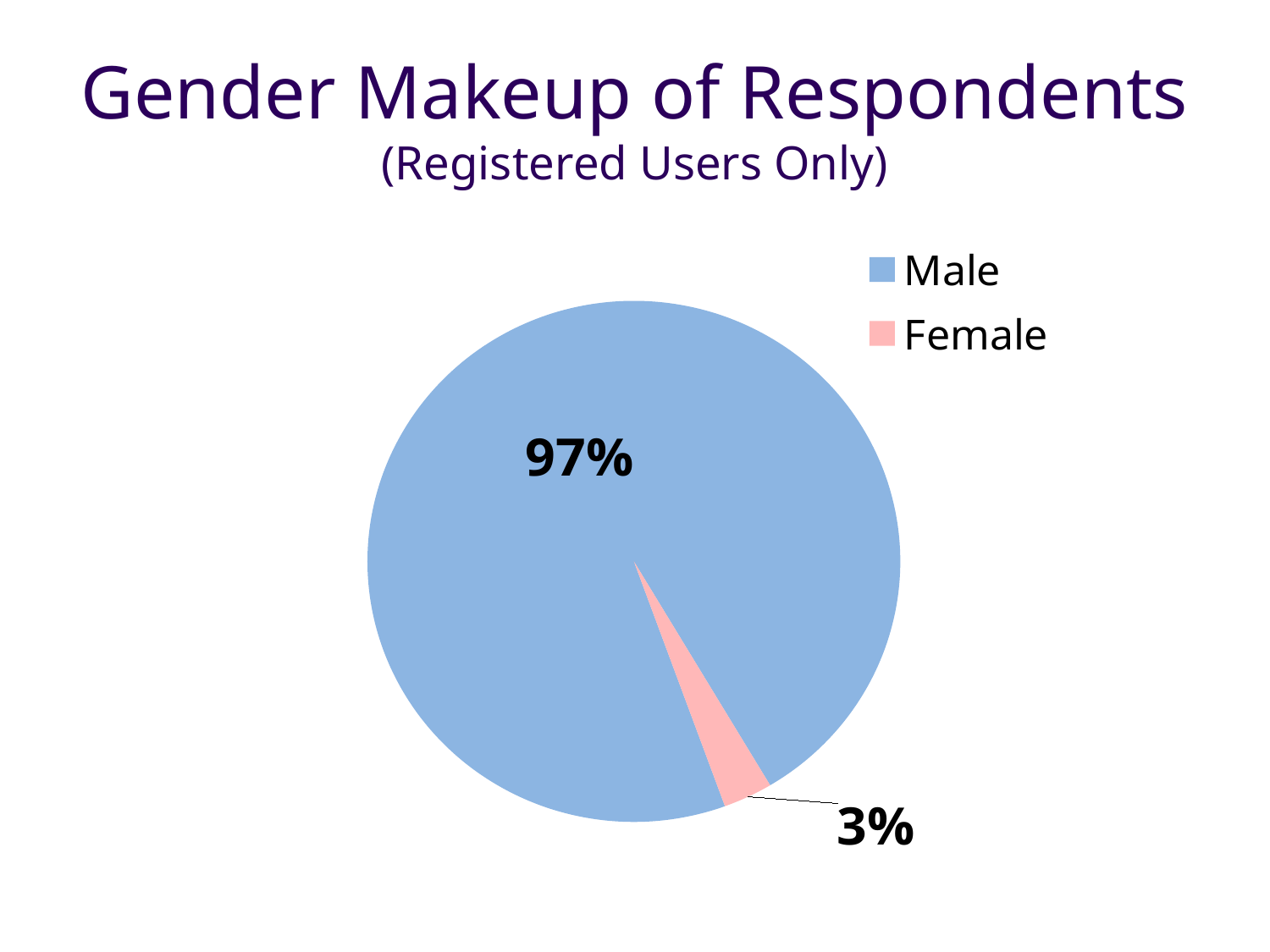
What is the difference in percentage points between the Male and Female shares? 94 Which is larger, the Male share or the Female share? Male Which category has the largest slice of the pie? Male How many entries does the legend list? 2 What share of respondents are Male? 97% What is the title of the slide? Gender Makeup of Respondents What colour is the Female slice in the pie chart? pink What share of respondents are Female? 3% How many categories does the pie chart show? 2 Which category has the smallest slice of the pie? Female What kind of chart is shown on the slide? pie chart